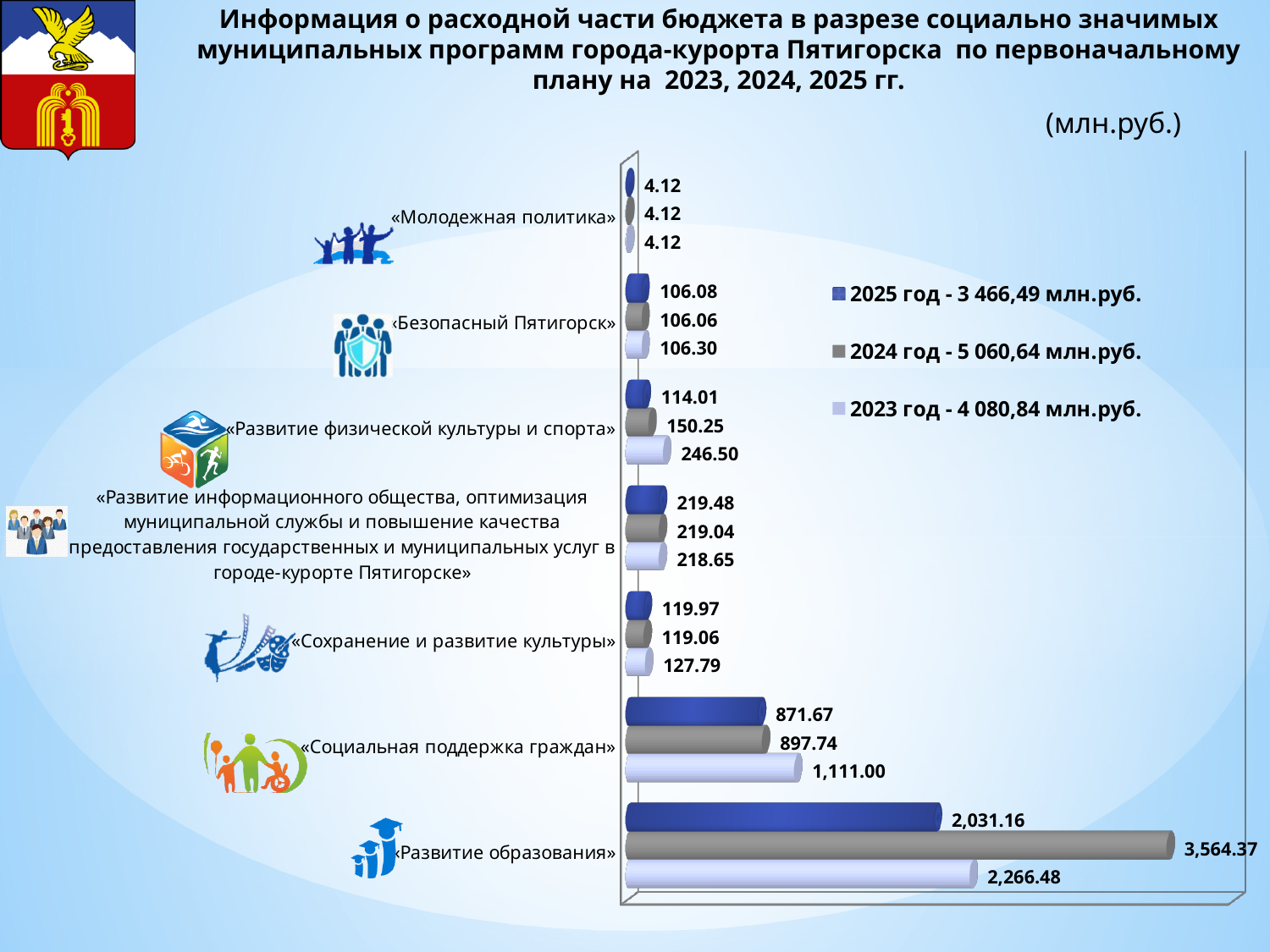
Which program has the highest 2025 value? «Развитие образования» How many series does the legend list? 3 What is the difference between the 2023 and 2024 values for «Социальная поддержка граждан»? 213.26 According to the legend, what is the total for 2024 год? 5 060,64 млн.руб. What is the 2025 value for «Сохранение и развитие культуры»? 119.97 What is the difference between the 2024 and 2025 values for «Развитие образования»? 1,533.21 How many programs (categories) are shown in the chart? 7 Which program has the lowest 2023 value? «Молодежная политика» What is the 2023 value for «Социальная поддержка граждан»? 1,111.00 For «Развитие физической культуры и спорта», which year has the larger value, 2023 or 2025? 2023 What is the 2024 value for «Развитие образования»? 3,564.37 What kind of chart is shown on the slide? Bar chart